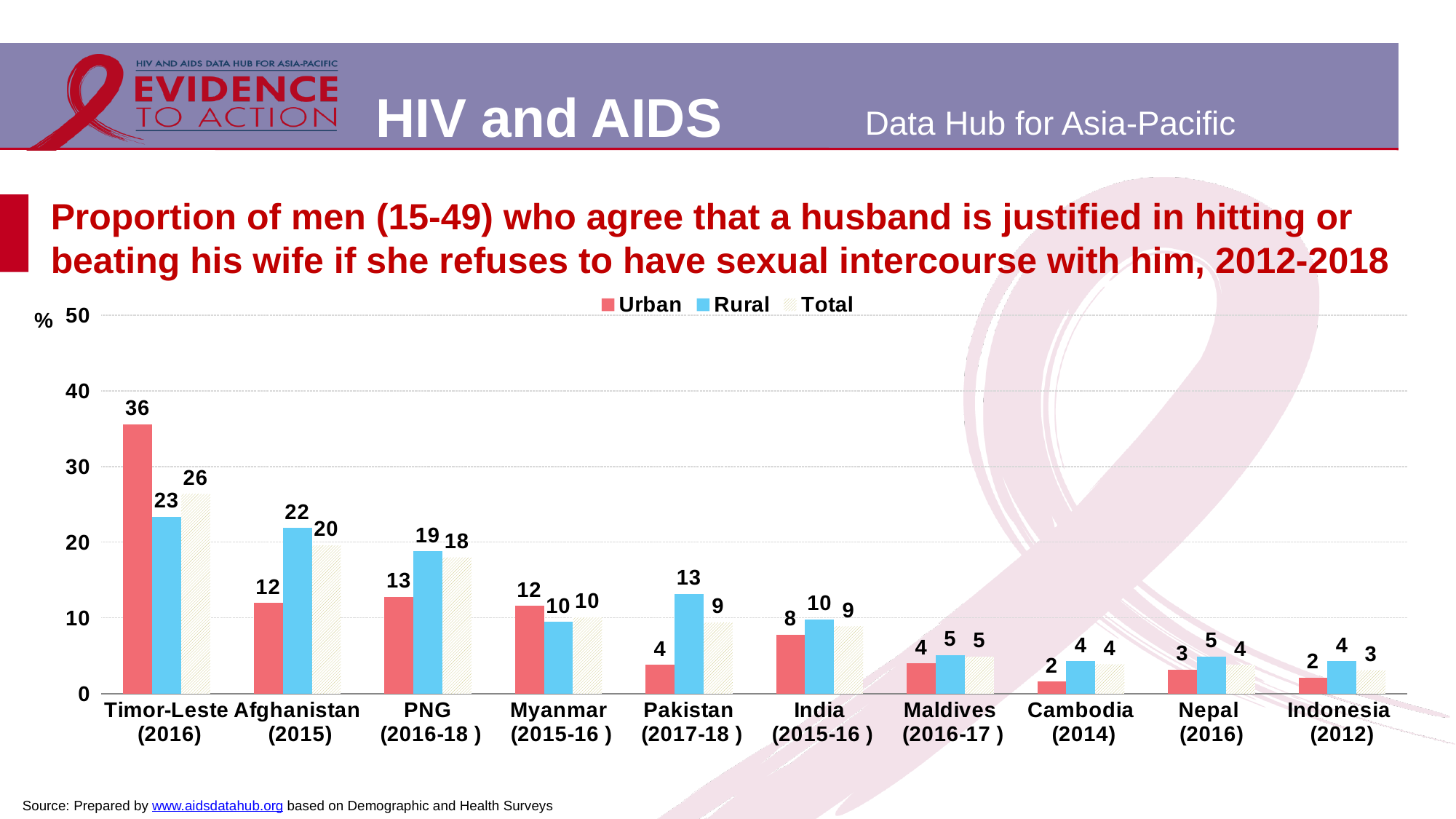
What is the Urban value for Timor-Leste (2016)? 36 What kind of chart is shown on the slide? Bar chart What is the Total value for PNG (2016-18)? 18 Is the Urban value for Timor-Leste (2016) greater or less than 30? greater Which is larger for Afghanistan (2015), the Urban value or the Rural value? Rural Which country has the lowest Total value? Indonesia (2012) Which country has the highest Urban value? Timor-Leste (2016) How many series does the legend list? 3 What is the difference between the Rural and Urban values for Pakistan (2017-18)? 9 What colour represents the Rural series in the legend? Blue How many countries are shown on the x axis? 10 What is the Rural value for Afghanistan (2015)? 22